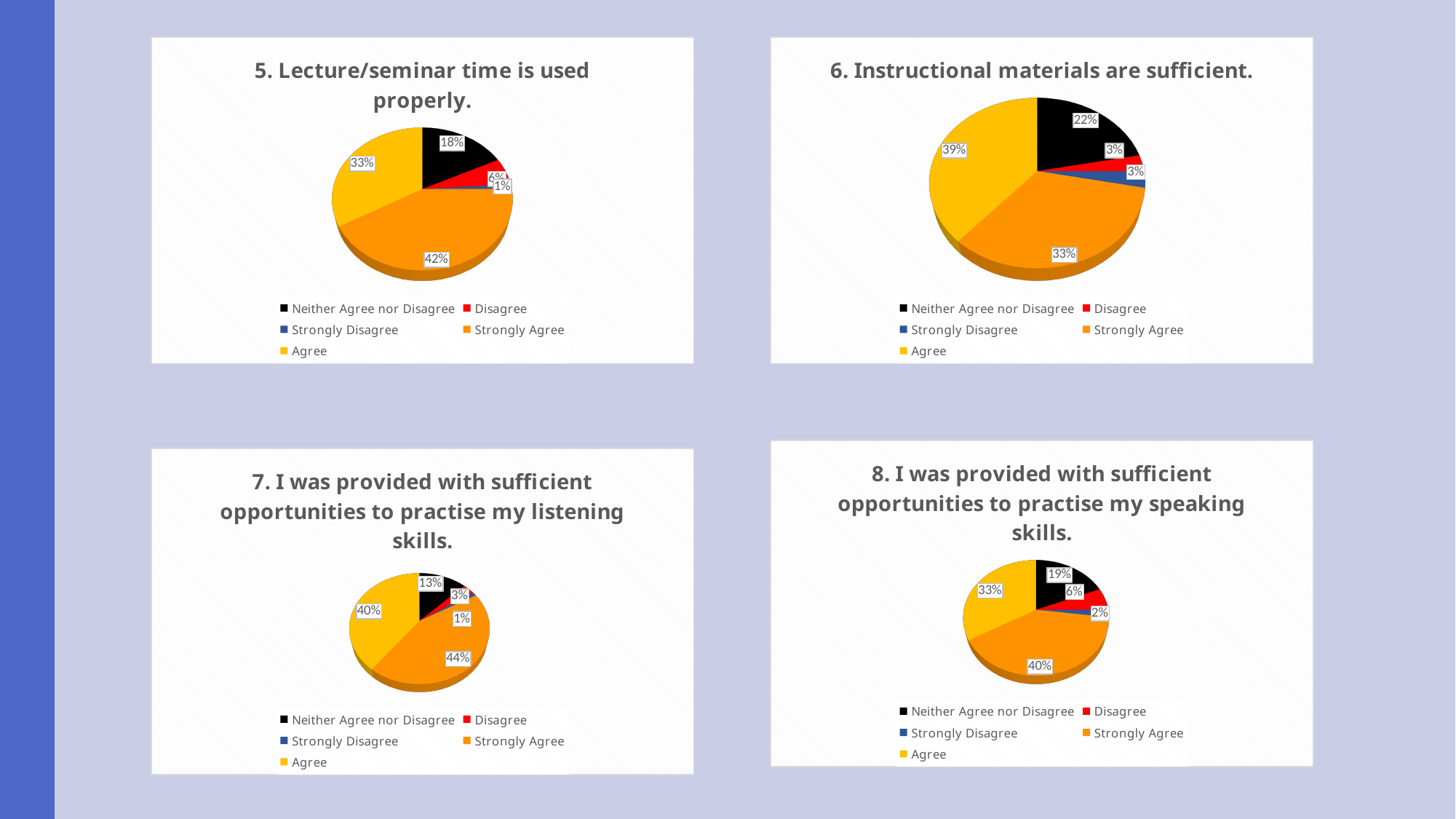
In the chart titled "5. Lecture/seminar time is used properly.", what percentage is shown for Neither Agree nor Disagree? 18% In the chart titled "6. Instructional materials are sufficient.", what percentage is shown for Neither Agree nor Disagree? 22% In the chart titled "8. I was provided with sufficient opportunities to practise my speaking skills.", what is the difference between the Strongly Agree and Neither Agree nor Disagree shares? 21% In the chart titled "5. Lecture/seminar time is used properly.", what percentage is shown for Strongly Agree? 42% In the chart titled "7. I was provided with sufficient opportunities to practise my listening skills.", what percentage is shown for Strongly Agree? 44% How many response categories does the legend list in the chart titled "6. Instructional materials are sufficient."? 5 In the chart titled "8. I was provided with sufficient opportunities to practise my speaking skills.", which response category has the smallest share? Strongly Disagree In the chart titled "6. Instructional materials are sufficient.", what is the difference between the Agree and Strongly Agree shares? 6% In the chart titled "7. I was provided with sufficient opportunities to practise my listening skills.", which is larger, Agree or Neither Agree nor Disagree? Agree In the chart titled "6. Instructional materials are sufficient.", which response category has the largest share? Agree In the chart titled "8. I was provided with sufficient opportunities to practise my speaking skills.", what percentage is shown for Agree? 33% What type of chart is used for "5. Lecture/seminar time is used properly."? Pie chart